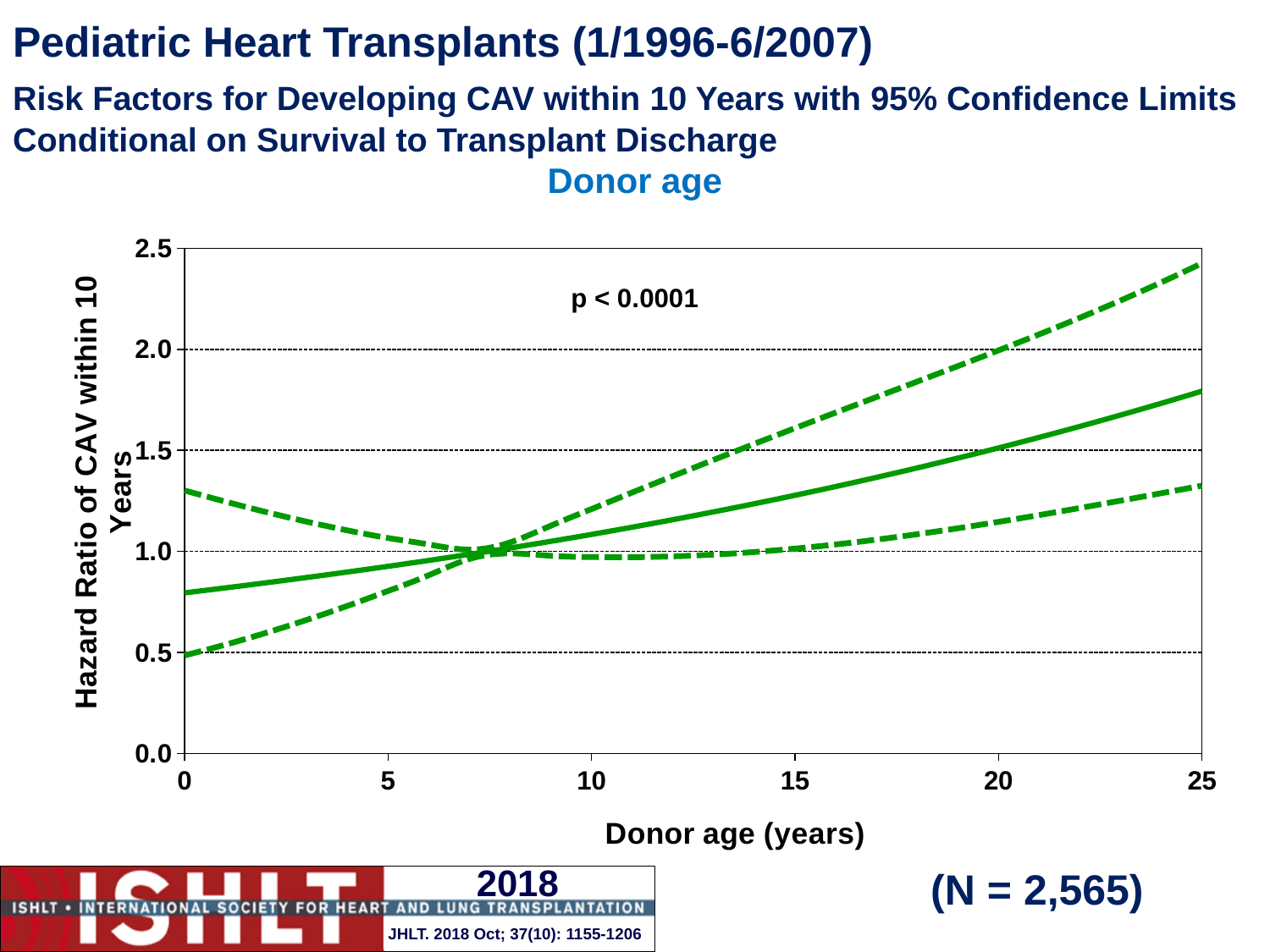
Is the solid hazard ratio line higher at a donor age of 25 years or at a donor age of 0 years? 25 years Is the upper dashed confidence limit at a donor age of 0 years greater or less than 1.0? greater What kind of chart is shown on the slide? line chart Is the solid hazard ratio line at a donor age of 0 years greater or less than 1.0? less Does the solid hazard ratio line rise or fall as donor age increases from 0 to 25 years? rise Is the solid hazard ratio line at a donor age of 25 years greater or less than 1.5? greater How many lines are plotted on the chart? 3 What p-value is printed on the chart? p < 0.0001 What is the label of the x axis? Donor age (years)